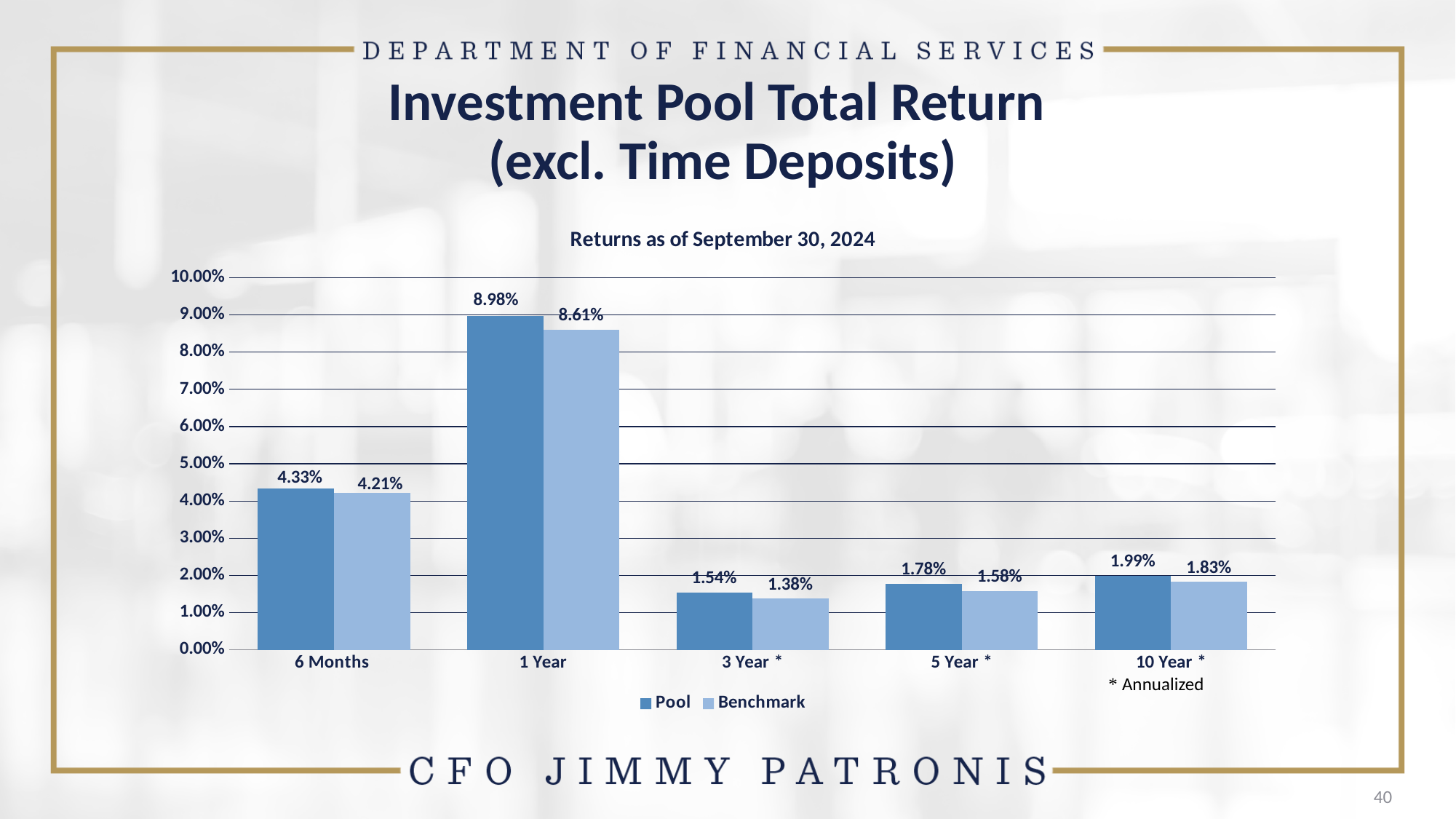
How many time periods are shown on the x axis? 5 How many series does the legend list? 2 What is the Benchmark return for the 5 Year period? 1.58% Is the Pool return for the 6 Months period greater or less than 4.00%? greater What kind of chart is shown on the slide? Bar chart What is the Pool return for the 10 Year period? 1.99% What is the Benchmark return for the 6 Months period? 4.21% Which period has the highest Pool return? 1 Year Which period has the lowest Benchmark return? 3 Year Which is larger for the 3 Year period, the Pool return or the Benchmark return? Pool What is the Pool return for the 1 Year period? 8.98% What is the difference between the Pool and Benchmark returns for the 1 Year period? 0.37%